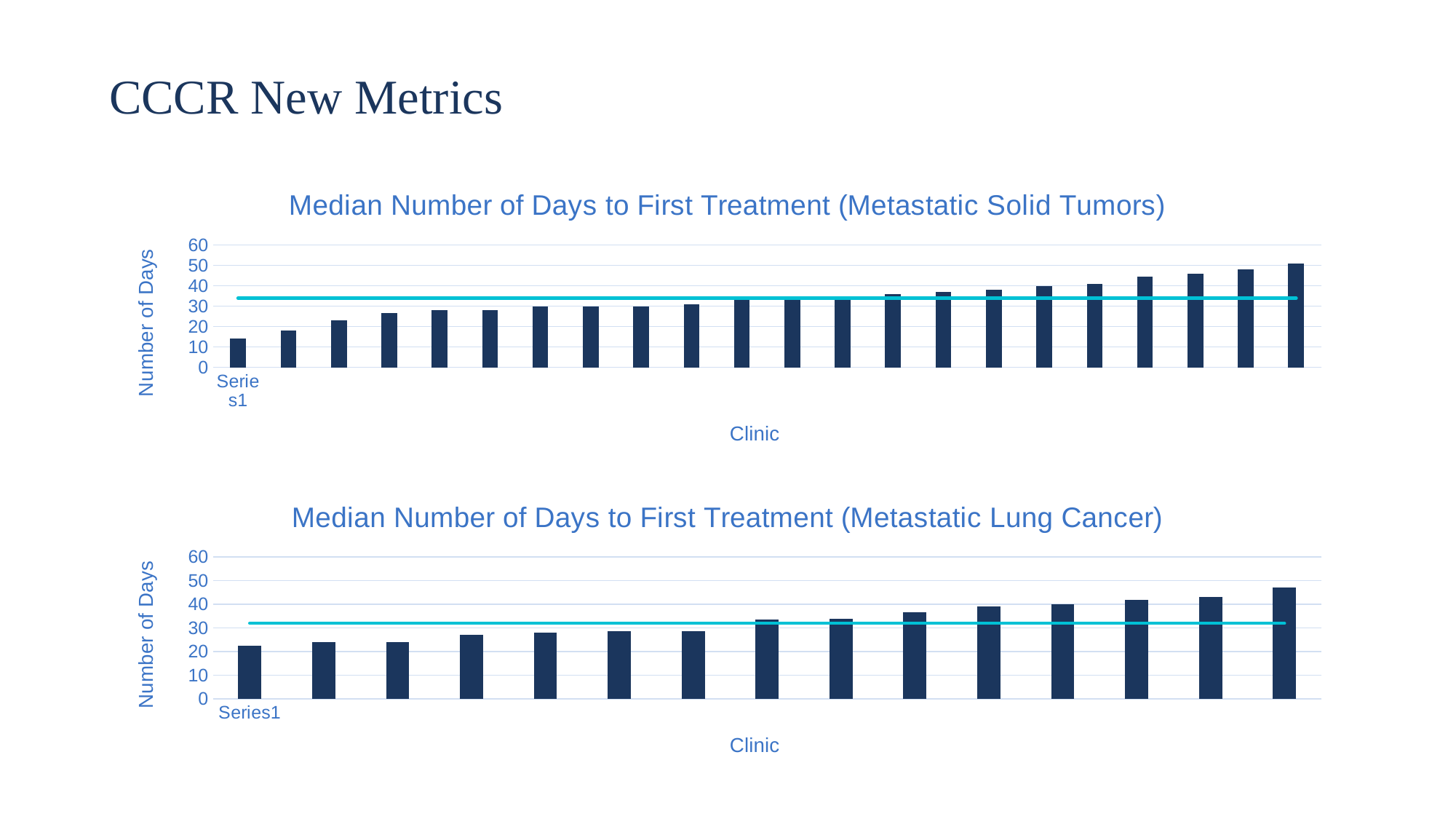
In the bottom chart (Metastatic Lung Cancer), is the value of the leftmost bar greater or less than 30? less What is the label on the vertical axis of the top chart? Number of Days What is the label on the horizontal axis of the bottom chart? Clinic What kind of chart is the top chart, 'Median Number of Days to First Treatment (Metastatic Solid Tumors)'? Bar chart In the bottom chart (Metastatic Lung Cancer), is the value of the rightmost bar greater or less than 40? greater In the bottom chart (Metastatic Lung Cancer), do the bar values rise or fall from left to right? Rise In the top chart (Metastatic Solid Tumors), is the value of the leftmost bar greater or less than 20? less In the top chart (Metastatic Solid Tumors), do the bar values rise or fall from left to right? Rise How many bars are plotted in the top chart (Metastatic Solid Tumors)? 22 How many bars are plotted in the bottom chart (Metastatic Lung Cancer)? 15 In the top chart (Metastatic Solid Tumors), which bar is the tallest: the leftmost or the rightmost? The rightmost